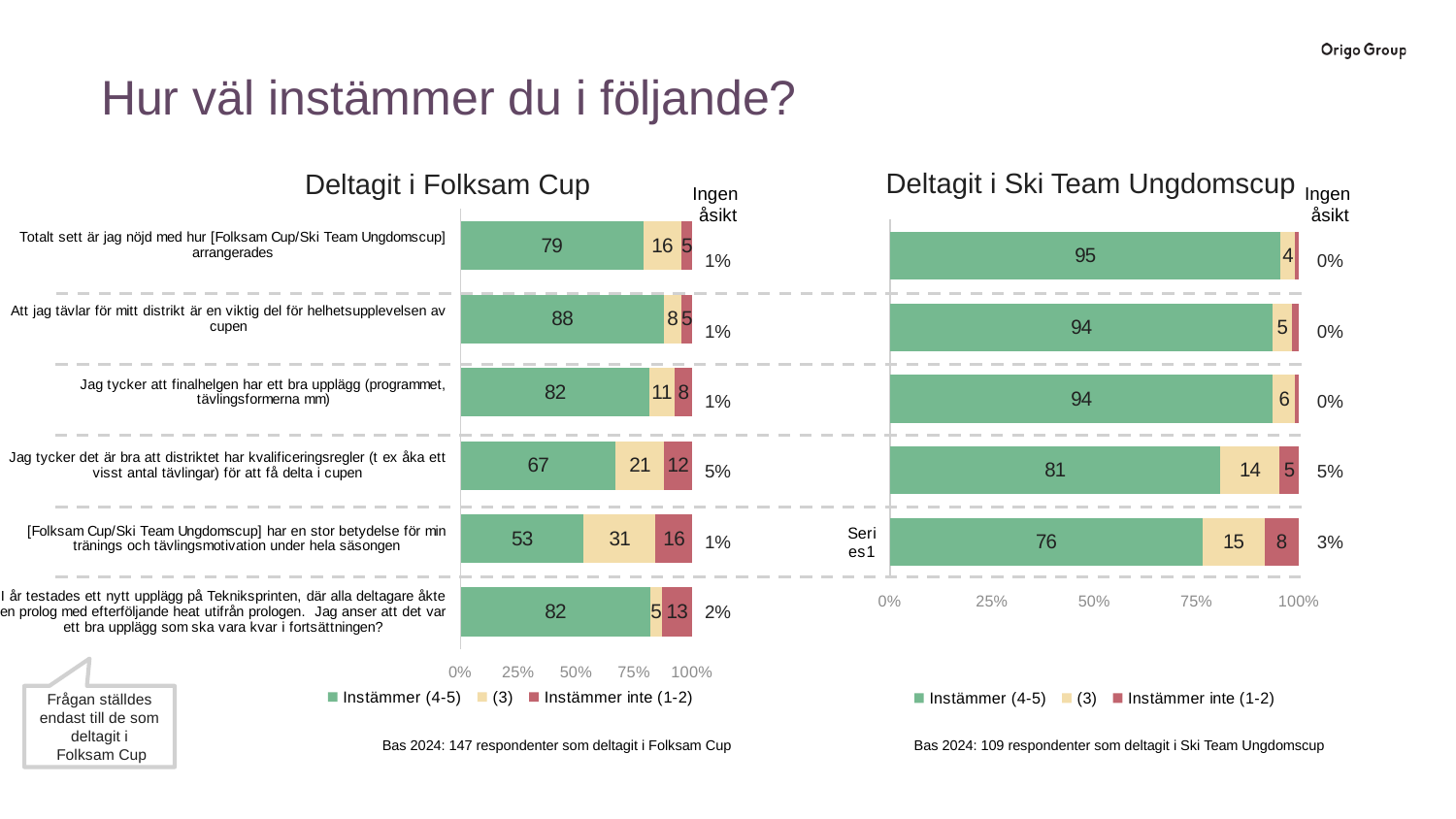
In the 'Deltagit i Folksam Cup' chart, which statement has the highest 'Instämmer (4-5)' value? Att jag tävlar för mitt distrikt är en viktig del för helhetsupplevelsen av cupen In the 'Deltagit i Folksam Cup' chart, which statement has the lowest 'Instämmer (4-5)' value? [Folksam Cup/Ski Team Ungdomscup] har en stor betydelse för min tränings och tävlingsmotivation under hela säsongen In the 'Deltagit i Folksam Cup' chart, what is the difference between the 'Instämmer (4-5)' values for 'Totalt sett är jag nöjd med hur [Folksam Cup/Ski Team Ungdomscup] arrangerades' and 'Jag tycker det är bra att distriktet har kvalificeringsregler (t ex åka ett visst antal tävlingar) för att få delta i cupen'? 12 In the 'Deltagit i Ski Team Ungdomscup' chart, what is the 'Instämmer inte (1-2)' value for the bottom bar? 8 In the 'Deltagit i Ski Team Ungdomscup' chart, what is the 'Instämmer (4-5)' value for the top bar? 95 How many series does the legend of the 'Deltagit i Ski Team Ungdomscup' chart list? 3 How many statements (categories) are shown in the 'Deltagit i Folksam Cup' chart? 6 What type of chart is 'Deltagit i Ski Team Ungdomscup'? Stacked bar chart In the 'Deltagit i Folksam Cup' chart, what is the 'Ingen åsikt' percentage for 'Jag tycker det är bra att distriktet har kvalificeringsregler (t ex åka ett visst antal tävlingar) för att få delta i cupen'? 5% In the 'Deltagit i Ski Team Ungdomscup' chart, is the 'Instämmer (4-5)' value for the bottom bar greater or less than 50%? greater In the 'Deltagit i Folksam Cup' chart, what is the 'Instämmer (4-5)' value for 'Att jag tävlar för mitt distrikt är en viktig del för helhetsupplevelsen av cupen'? 88 In the 'Deltagit i Folksam Cup' chart, what is the '(3)' value for '[Folksam Cup/Ski Team Ungdomscup] har en stor betydelse för min tränings och tävlingsmotivation under hela säsongen'? 31